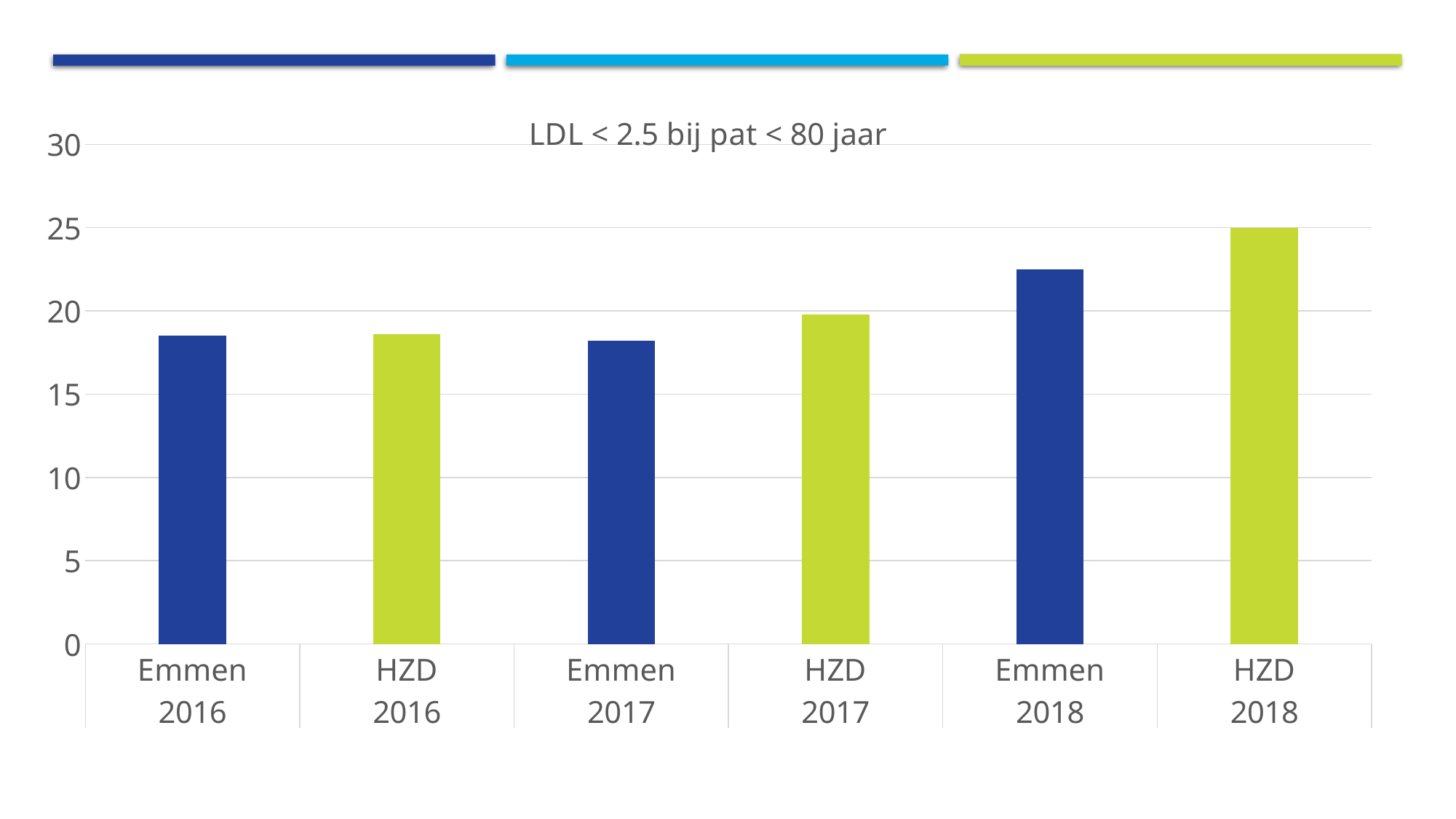
Is the value for Emmen 2017 greater or less than 15? greater What colour are the Emmen bars? dark blue What kind of chart is shown on the slide? bar chart Is the value for HZD 2018 greater or less than 20? greater Is the value for Emmen 2018 greater or less than 20? greater Do the HZD values rise or fall from 2016 to 2018? rise Which is larger, the value for Emmen 2017 or HZD 2017? HZD 2017 Which is larger, the value for Emmen 2018 or HZD 2018? HZD 2018 What is the title of the chart? LDL < 2.5 bij pat < 80 jaar How many bars are plotted in the chart? 6 Which category has the highest value? HZD 2018